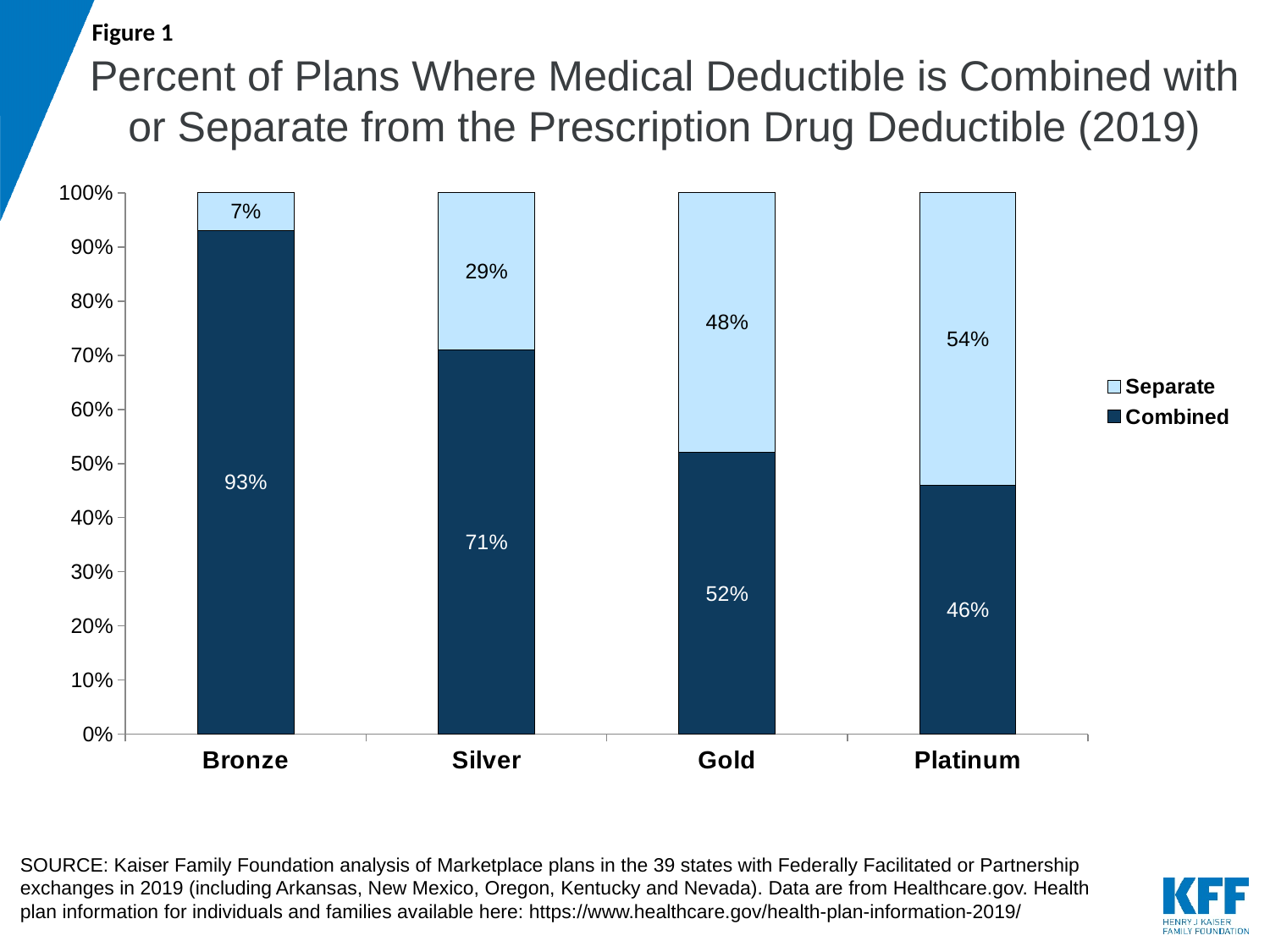
What percent of Platinum plans have a Separate deductible? 54% Which metal level has the highest share of plans with a Combined deductible? Bronze How many series does the legend list? 2 How many metal levels are shown on the x axis? 4 Is the Separate share larger for Gold or for Platinum? Platinum What kind of chart is shown on the slide? Stacked bar chart What percent of Silver plans have a Separate deductible? 29% What percent of Gold plans have a Combined deductible? 52% What percent of Bronze plans have a Combined deductible? 93% Does the Combined share rise or fall moving from Bronze to Platinum along the x axis? Fall What is the difference between the Combined share for Silver and the Combined share for Platinum? 25% Which metal level has the lowest share of plans with a Separate deductible? Bronze